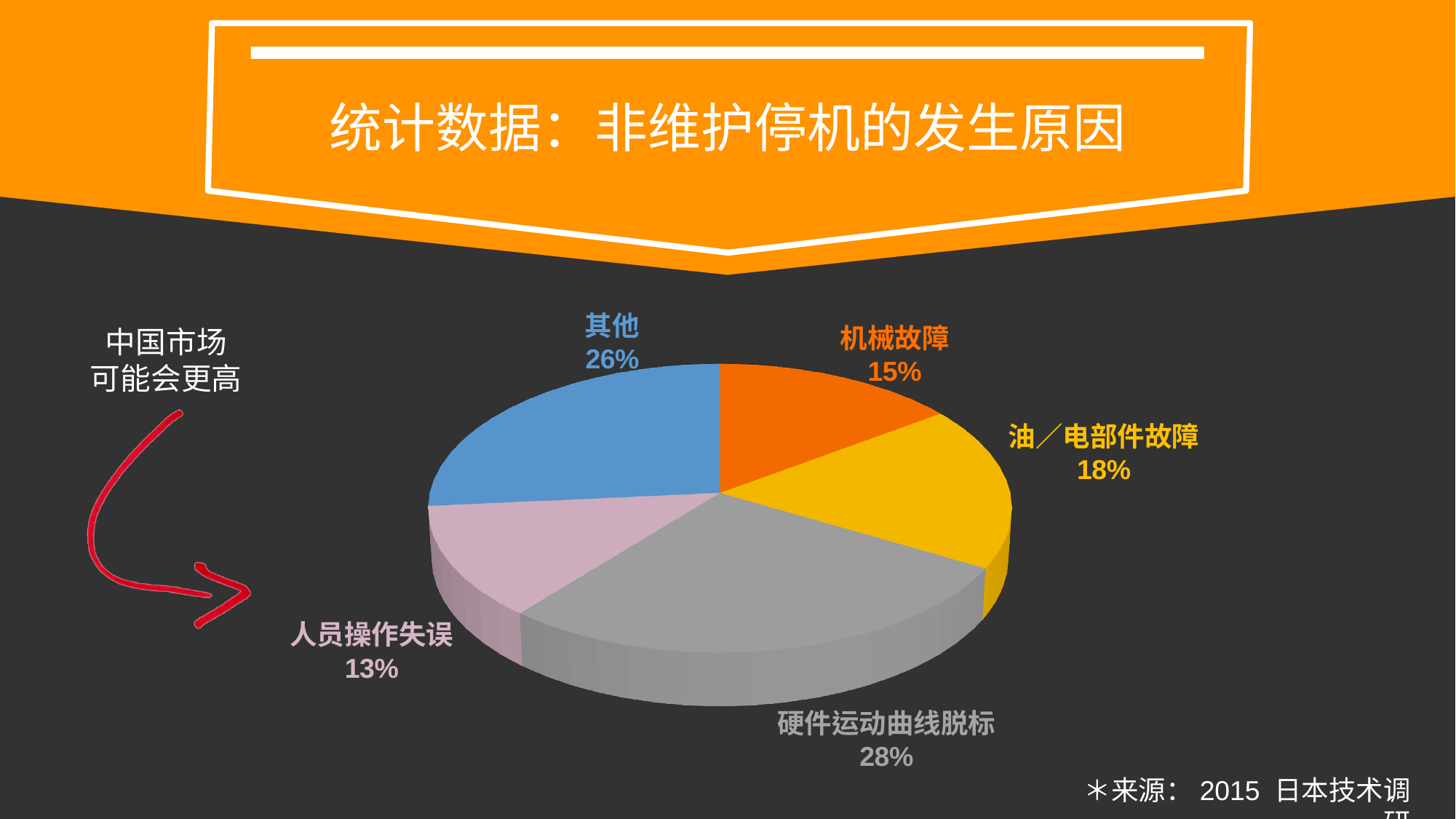
What type of chart is shown on the slide? Pie chart What is the combined share of 硬件运动曲线脱标 and 其他? 54% What is the value shown for 机械故障? 15% What colour is the slice for 其他? Blue What percentage is shown for 人员操作失误? 13% Which category has the smallest share of the pie? 人员操作失误 What is the difference in percentage points between 其他 and 机械故障? 11 What percentage of non-maintenance downtime is attributed to 硬件运动曲线脱标? 28% Which is larger, 油／电部件故障 or 机械故障? 油／电部件故障 Which category has the largest share of the pie? 硬件运动曲线脱标 How many categories are shown in the pie chart? 5 What share does 油／电部件故障 account for? 18%